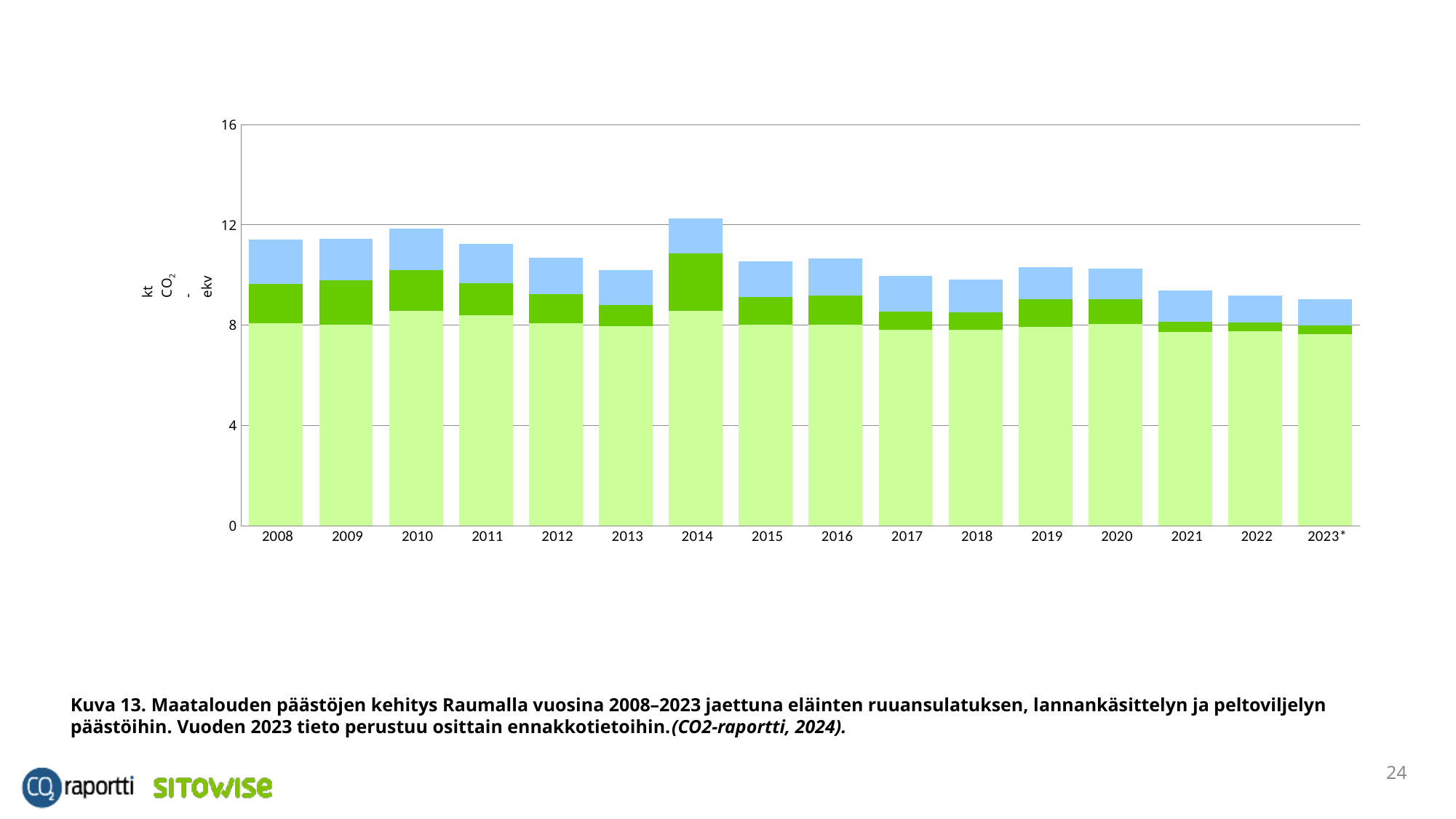
Is the total value for 2013 greater or less than 8? greater What kind of chart is shown on the slide? stacked bar chart How many coloured segments does each stacked bar have? 3 Which year has the larger total bar, 2014 or 2013? 2014 Is the total value for 2014 greater or less than 12? greater Is the total value for 2023* greater or less than 12? less Which year has the larger total bar, 2010 or 2021? 2010 How many years (bars) are shown on the x axis? 16 Do the total bar heights generally rise or fall from 2008 to 2023*? fall What unit is shown on the y axis? kt CO2-ekv Which year has the highest total bar? 2014